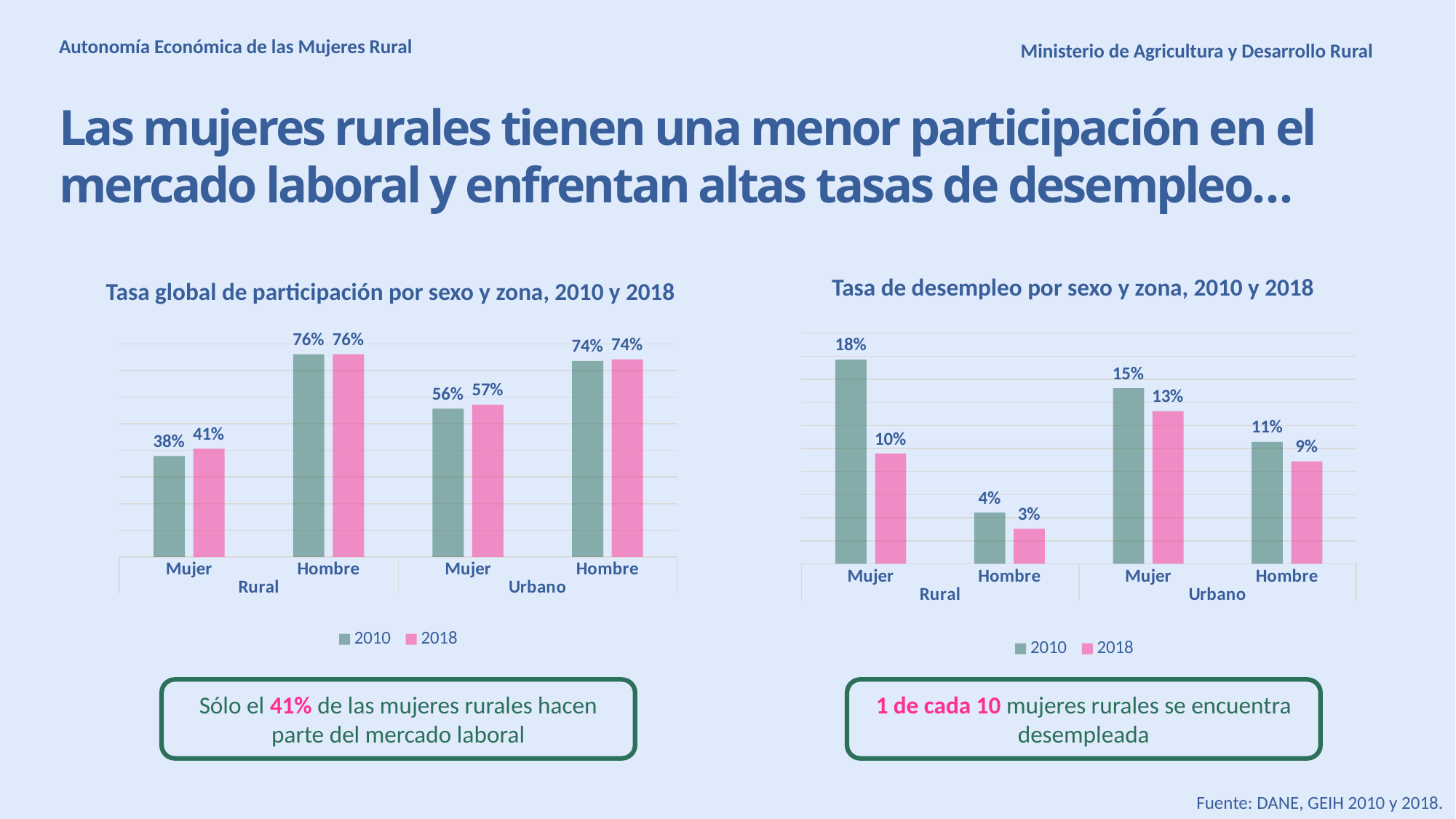
In the chart 'Tasa de desempleo por sexo y zona, 2010 y 2018', which colour represents the 2018 series? Pink How many series does the legend list in the chart 'Tasa global de participación por sexo y zona, 2010 y 2018'? 2 In the chart 'Tasa global de participación por sexo y zona, 2010 y 2018', which group has the highest value in 2010? Hombre Rural In the chart 'Tasa de desempleo por sexo y zona, 2010 y 2018', which is larger: Mujer Urbano in 2010 or Mujer Rural in 2018? Mujer Urbano in 2010 In the chart 'Tasa global de participación por sexo y zona, 2010 y 2018', what is the value for Hombre in the Urbano zone in 2010? 74% In the chart 'Tasa global de participación por sexo y zona, 2010 y 2018', what is the value for Mujer in the Rural zone in 2018? 41% In the chart 'Tasa global de participación por sexo y zona, 2010 y 2018', what is the difference between Hombre and Mujer in the Rural zone in 2018? 35% In the chart 'Tasa de desempleo por sexo y zona, 2010 y 2018', what is the difference between the 2010 and 2018 values for Mujer in the Rural zone? 8% In the chart 'Tasa de desempleo por sexo y zona, 2010 y 2018', what is the value for Mujer in the Rural zone in 2010? 18% In the chart 'Tasa de desempleo por sexo y zona, 2010 y 2018', which group has the lowest value in 2018? Hombre Rural What kind of chart is 'Tasa de desempleo por sexo y zona, 2010 y 2018'? Bar chart In the chart 'Tasa de desempleo por sexo y zona, 2010 y 2018', what is the value for Hombre in the Urbano zone in 2018? 9%